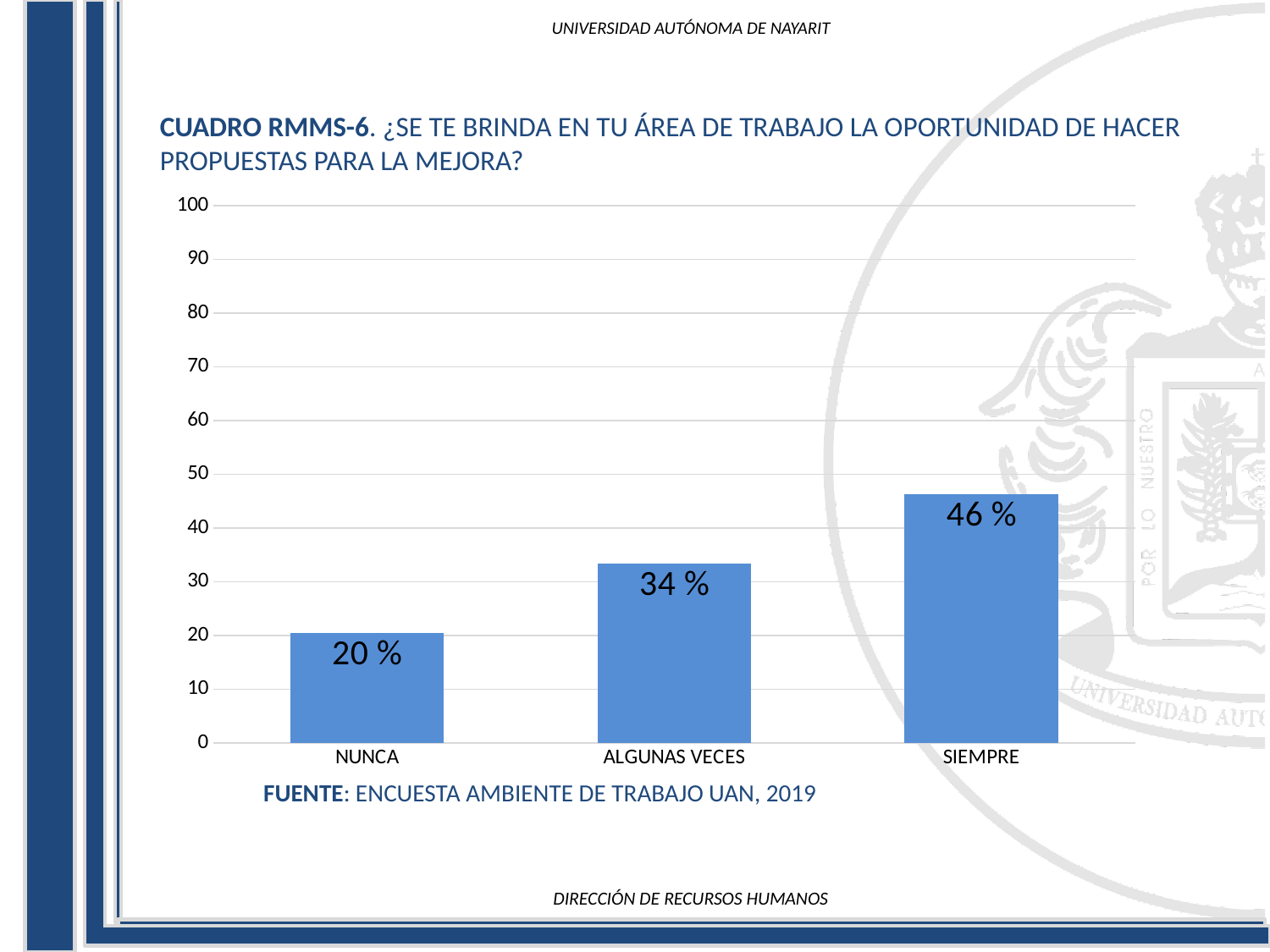
What is the difference between the values for SIEMPRE and NUNCA? 26 % What is the value for NUNCA? 20 % What is the difference between the values for ALGUNAS VECES and NUNCA? 14 % What kind of chart is shown on the slide? bar chart Which category has the highest value? SIEMPRE What is the value for SIEMPRE? 46 % Which category has the lowest value? NUNCA How many categories are shown on the x axis? 3 Which is larger, the value for ALGUNAS VECES or the value for SIEMPRE? SIEMPRE Do the values rise or fall from left to right along the x axis? rise What is the value for ALGUNAS VECES? 34 % Is the value for SIEMPRE greater or less than 50? less